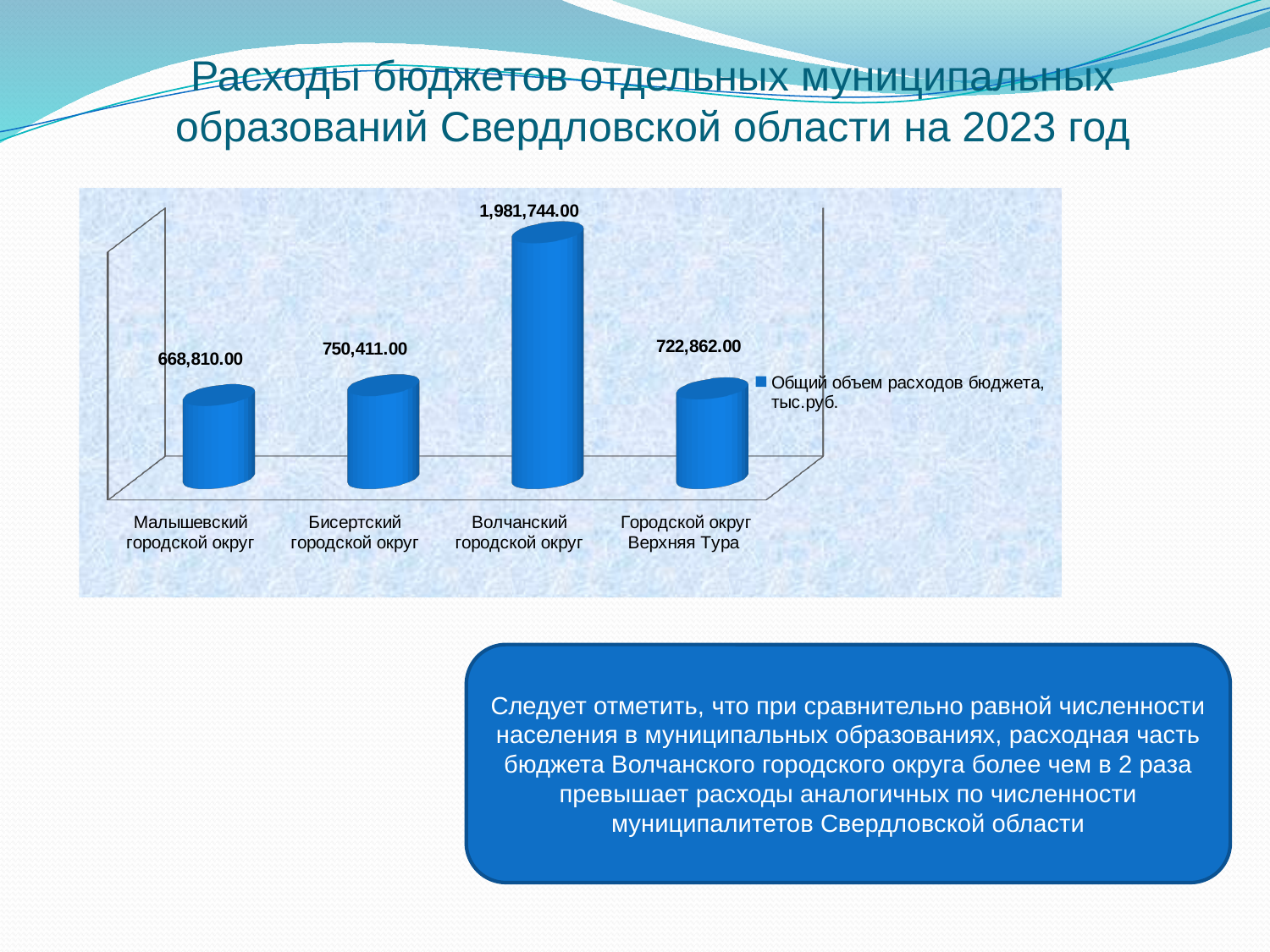
Which category has the highest value? Волчанский городской округ What is the value for Малышевский городской округ? 668,810.00 What kind of chart is shown on the slide? Bar chart What is the legend entry of the series shown on the chart? Общий объем расходов бюджета, тыс.руб. Which category has the lowest value? Малышевский городской округ What is the value for Волчанский городской округ? 1,981,744.00 What is the difference between the values for Волчанский городской округ and Бисертский городской округ? 1,231,333.00 What is the value for Городской округ Верхняя Тура? 722,862.00 What is the difference between the values for Бисертский городской округ and Малышевский городской округ? 81,601.00 Which is larger: the value for Бисертский городской округ or the value for Городской округ Верхняя Тура? Бисертский городской округ What is the value for Бисертский городской округ? 750,411.00 How many categories are shown on the chart? 4